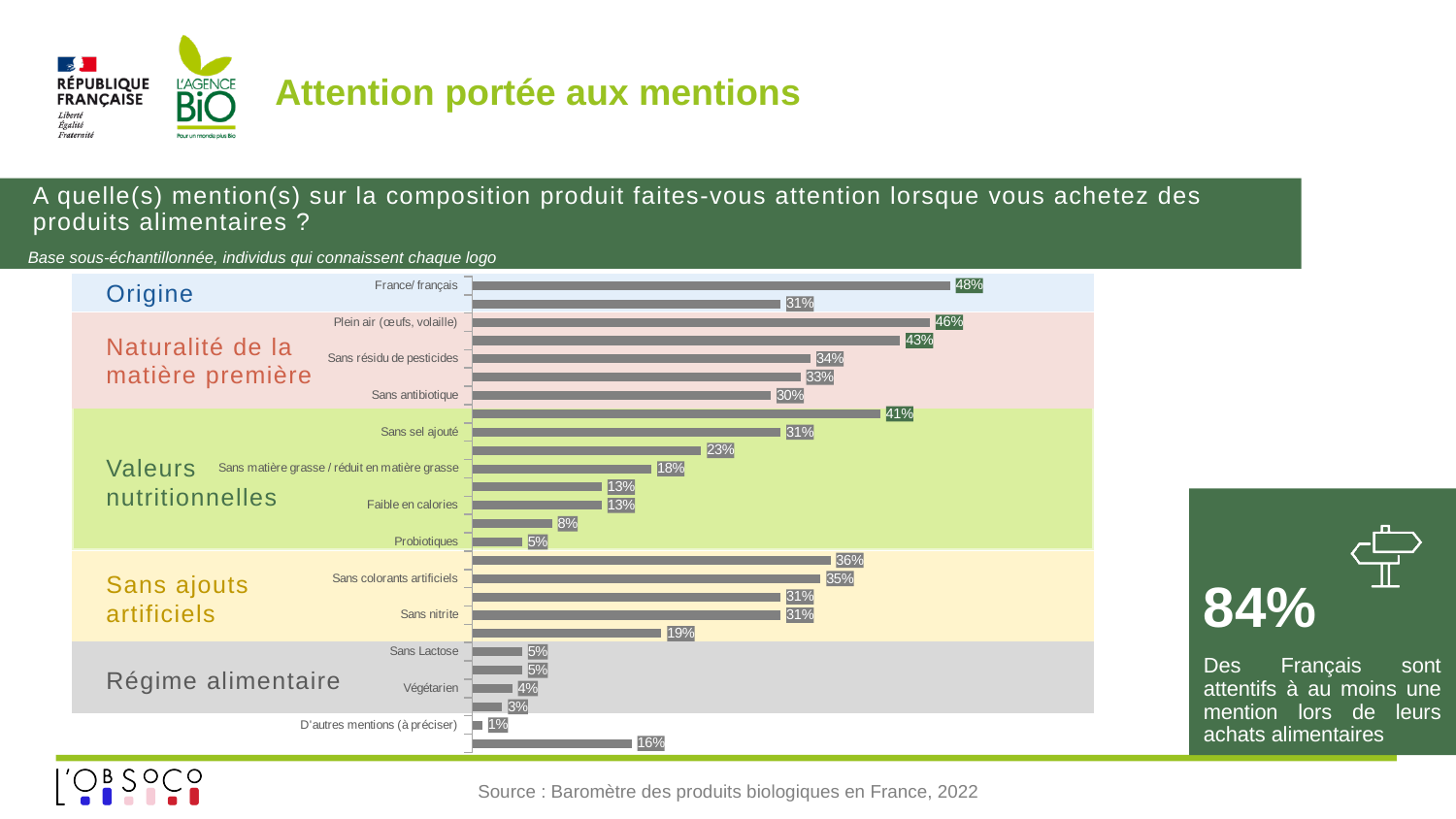
What is the highest value shown in the chart? 48% What is the source cited at the bottom of the slide? Baromètre des produits biologiques en France, 2022 What kind of chart is shown on the slide? bar chart What is the difference between the bar aligned with 'France/ français' (48%) and the bar aligned with 'Plein air (œufs, volaille)' (46%)? 2% What is the value of the bar aligned with the label 'Probiotiques'? 5% What is the lowest value shown in the chart? 1% What percentage of French people are attentive to at least one mention during their food purchases, according to the callout? 84% What is the value of the bar aligned with the label 'Plein air (œufs, volaille)'? 46% Which is larger, the bar aligned with 'France/ français' or the bar aligned with 'Plein air (œufs, volaille)'? France/ français What is the value of the bar aligned with the label 'France/ français'? 48% How many category groups (coloured bands) are shown on the left of the chart? 5 What is the value of the bar aligned with the label 'D'autres mentions (à préciser)'? 1%